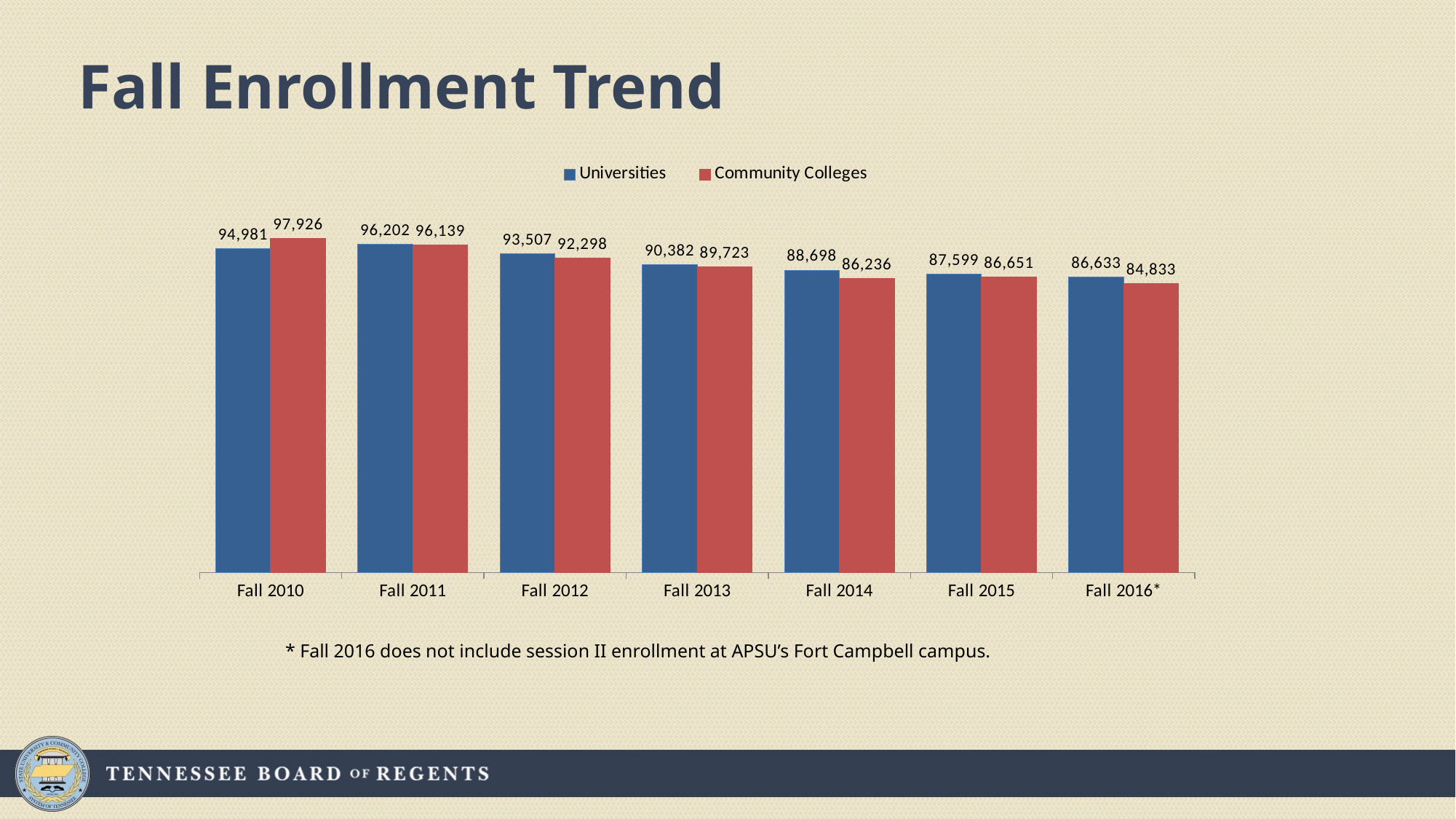
How many fall terms are shown on the x axis? 7 What kind of chart is shown on the slide? Bar chart How many series does the legend list? 2 What is the Universities enrollment for Fall 2010? 94,981 What is the Community Colleges enrollment for Fall 2016*? 84,833 In which fall term is the Universities enrollment highest? Fall 2011 Does Community Colleges enrollment generally rise or fall from Fall 2010 to Fall 2016*? Fall Which is larger in Fall 2010, Universities or Community Colleges enrollment? Community Colleges What colour represents the Universities series? Blue What is the difference between Universities and Community Colleges enrollment in Fall 2014? 2,462 What is the Community Colleges enrollment for Fall 2013? 89,723 In which fall term is the Community Colleges enrollment lowest? Fall 2016*